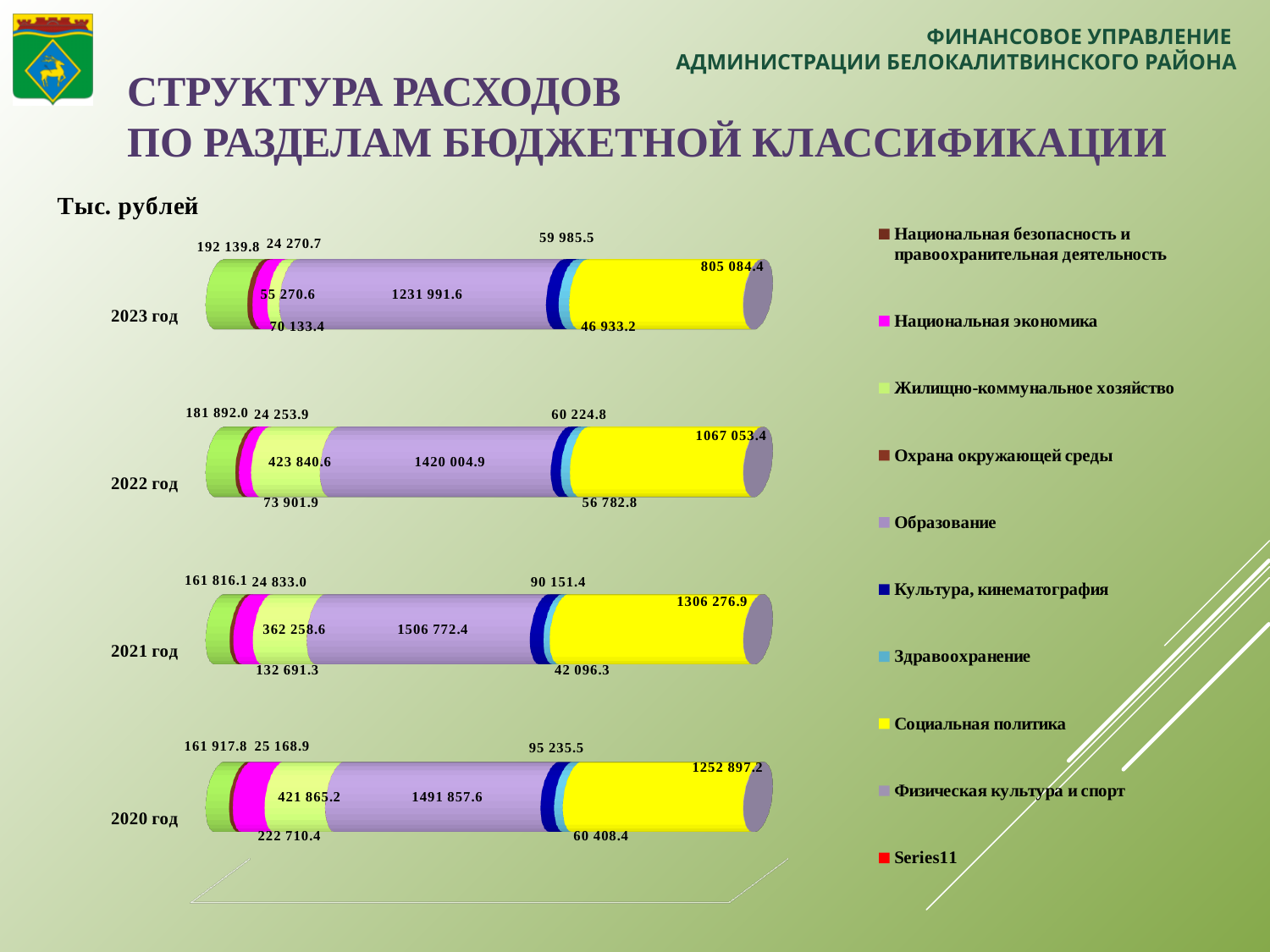
What is the value labelled on the largest (lavender, Образование) segment of the 2022 год bar? 1420 004.9 From 2021 год to 2023 год, does the yellow (Социальная политика) segment value rise or fall? fall In which year is the lavender (Образование) segment value the lowest? 2023 год What unit is stated above the chart? Тыс. рублей What kind of chart is shown on the slide? bar chart What is the value labelled on the yellow (Социальная политика) segment of the 2020 год bar? 1252 897.2 What is the value labelled on the largest (lavender, Образование) segment of the 2023 год bar? 1231 991.6 What is the difference between the lavender (Образование) segment values for 2021 год and 2023 год? 274 780.8 How many years (bars) does the chart show? 4 In which year is the yellow (Социальная политика) segment value the highest? 2021 год How many entries does the chart legend list? 10 Which year has the larger yellow (Социальная политика) segment value, 2022 год or 2023 год? 2022 год